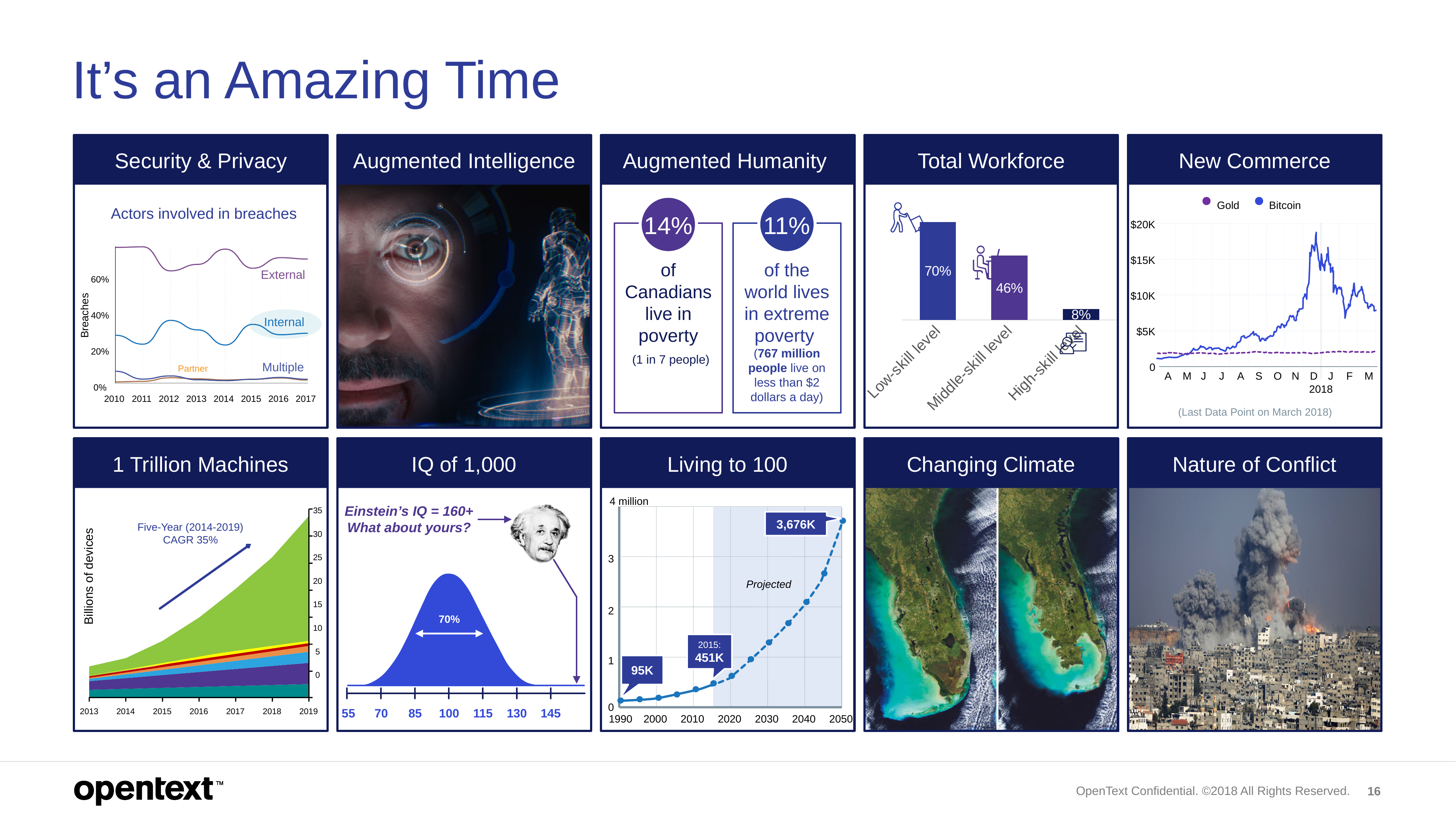
In the Security & Privacy chart (Actors involved in breaches), which actor has the highest share of breaches across the years? External In the Living to 100 chart, what is the value labelled for 2015? 451K In the New Commerce chart, is the peak value of Bitcoin greater or less than $15K? greater In the Security & Privacy chart, is the value for External in 2010 greater or less than 60%? greater In the Total Workforce chart, which skill level has the lowest value? High-skill level In the Living to 100 chart, what is the value labelled at 2050? 3,676K In the Total Workforce chart, what is the value for Low-skill level? 70% What kind of chart is shown in the Total Workforce panel? bar chart In the Living to 100 chart, do the values rise or fall from 1990 to 2050? rise In the Total Workforce chart, what is the difference between the Low-skill level and High-skill level values? 62% How many series does the legend of the New Commerce chart list? 2 In the Total Workforce chart, what is the value for Middle-skill level? 46%